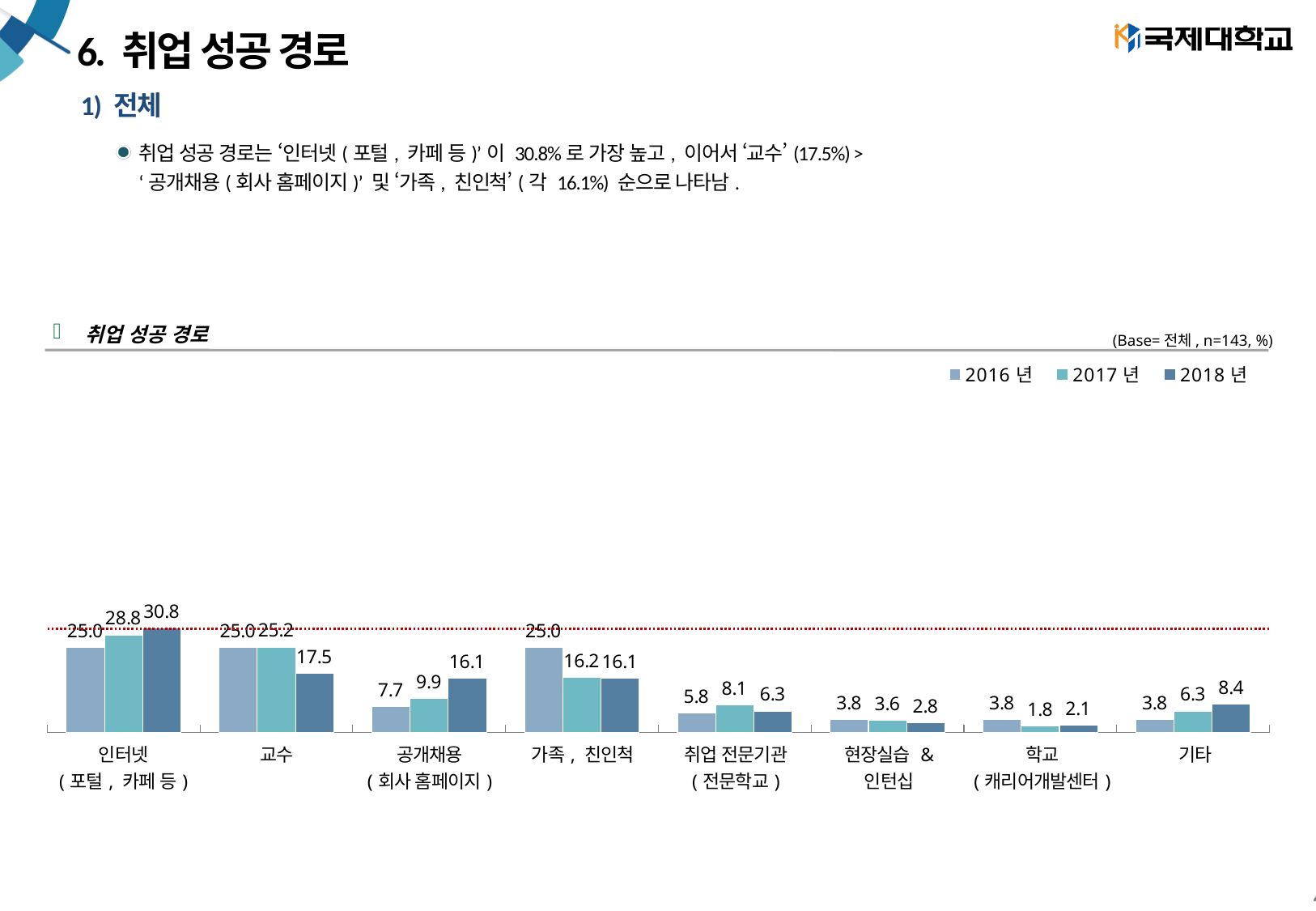
Which category has the lowest 2017년 value? 학교 (캐리어개발센터) What is the base sample size (n) noted on the chart? n=143 What is the 2016년 value for 취업 전문기관 (전문학교)? 5.8 Which is larger for 교수: the 2017년 value or the 2018년 value? 2017년 What is the difference between the 2018년 and 2016년 values for 공개채용 (회사 홈페이지)? 8.4 How many categories are shown on the x axis of the chart? 8 Do the values for 기타 rise or fall from 2016년 to 2018년? rise What type of chart is shown on the slide? bar chart How many series does the legend list? 3 Which category has the highest 2018년 value? 인터넷 (포털, 카페 등) What is the 2018년 value for 인터넷 (포털, 카페 등)? 30.8 What is the 2017년 value for 공개채용 (회사 홈페이지)? 9.9